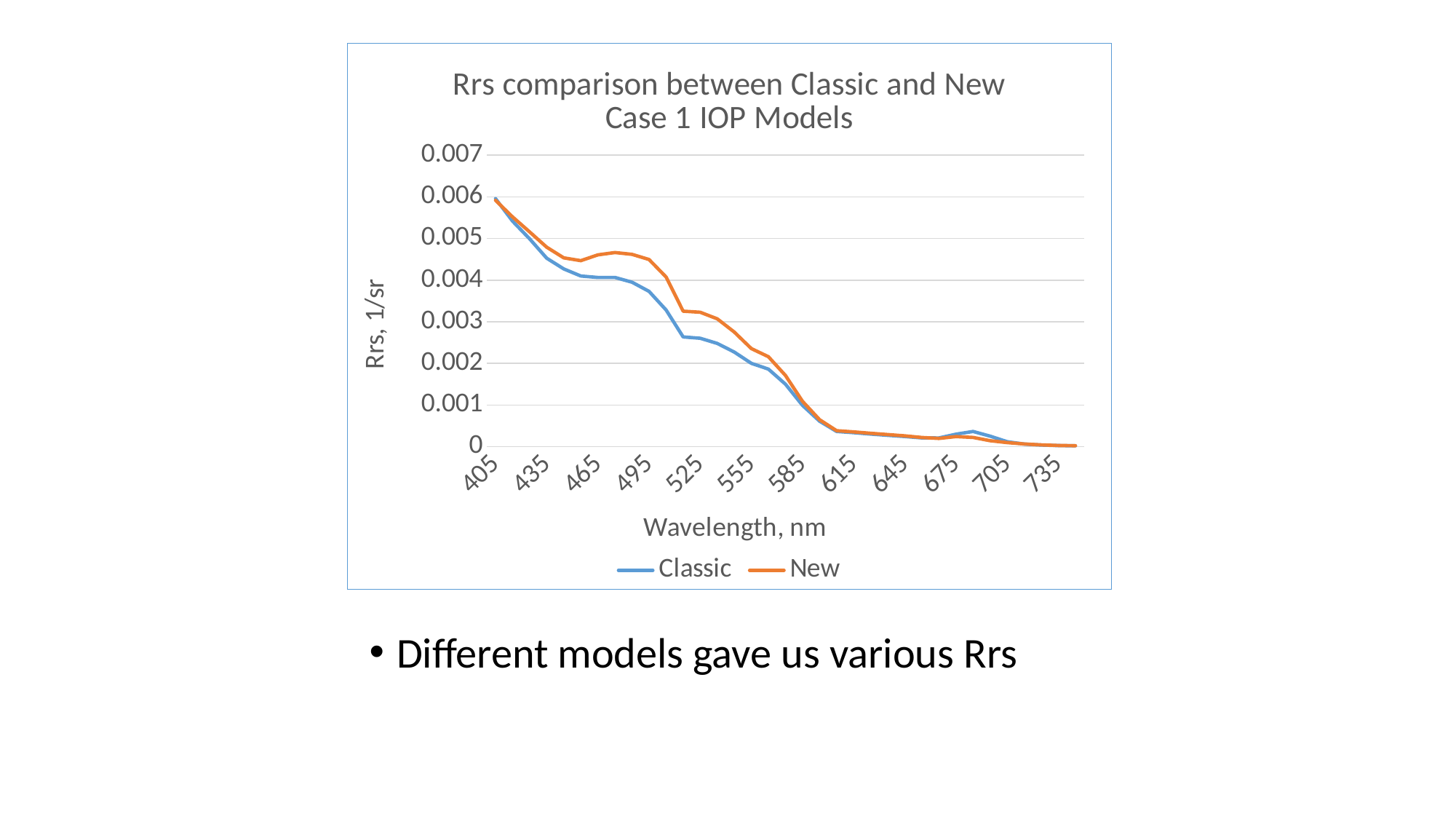
Is the Classic value at 435 nm greater or less than 0.004? greater What is the title of the chart? Rrs comparison between Classic and New Case 1 IOP Models Is the New value at 495 nm greater or less than 0.004? greater Is the Classic value at 615 nm greater or less than 0.001? less What are the names of the two series in the legend? Classic and New How many series does the legend list? 2 At 495 nm, which series has the larger Rrs value, Classic or New? New What kind of chart is shown on the slide? line chart Do the Rrs values generally rise or fall as wavelength increases from 405 to 735 nm? fall At 525 nm, which series has the larger Rrs value, Classic or New? New